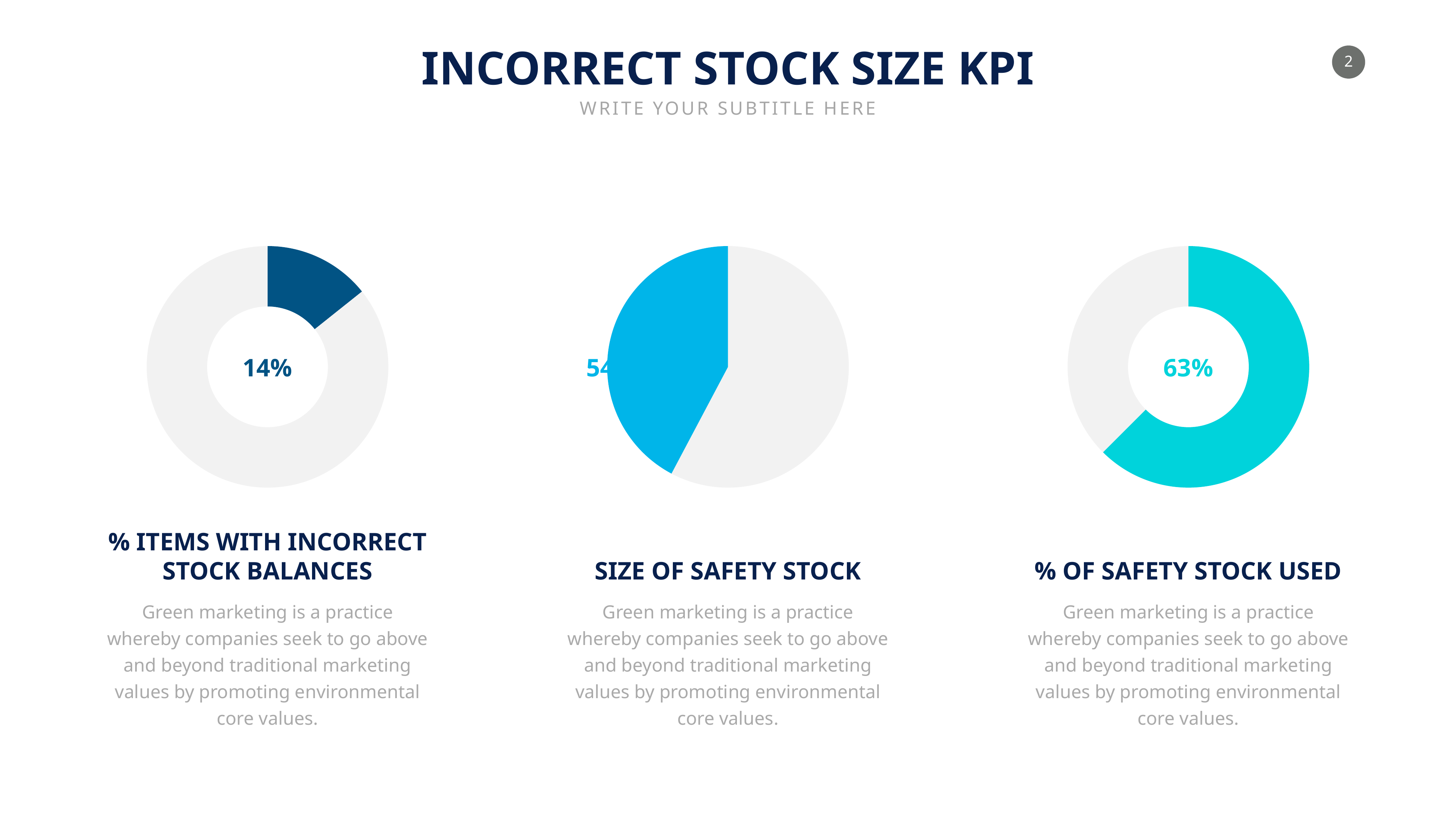
What share of the '% ITEMS WITH INCORRECT STOCK BALANCES' donut does the dark blue segment represent? 14% In the '% OF SAFETY STOCK USED' chart, is the highlighted value greater or less than 50%? greater What value is shown in the centre of the '% ITEMS WITH INCORRECT STOCK BALANCES' chart? 14% What value is shown in the centre of the '% OF SAFETY STOCK USED' chart? 63% What kind of chart is used for '% ITEMS WITH INCORRECT STOCK BALANCES'? donut chart What kind of chart is used for 'SIZE OF SAFETY STOCK'? pie chart In the '% ITEMS WITH INCORRECT STOCK BALANCES' chart, is the highlighted value greater or less than 50%? less How many charts are shown on the slide? 3 Which is larger: the value in the '% ITEMS WITH INCORRECT STOCK BALANCES' chart or the value in the '% OF SAFETY STOCK USED' chart? % OF SAFETY STOCK USED What colour is the highlighted segment in the '% OF SAFETY STOCK USED' chart? cyan What is the title of the middle chart on the slide? SIZE OF SAFETY STOCK What is the difference between the value in the '% OF SAFETY STOCK USED' chart and the value in the '% ITEMS WITH INCORRECT STOCK BALANCES' chart? 49 percentage points